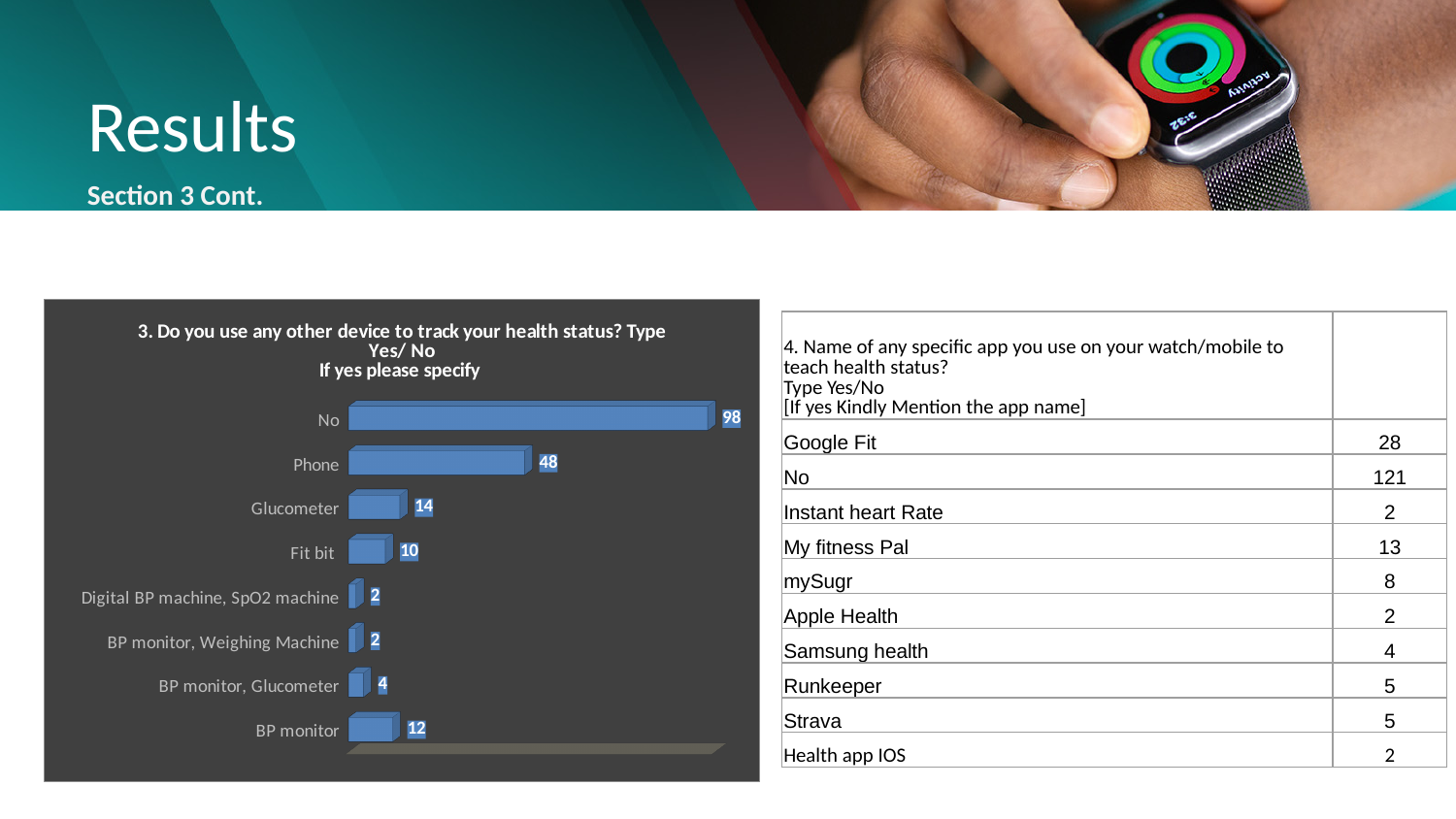
What is the value for "Fit bit" in the chart? 10 Which is larger in the chart, the value for "Glucometer" or the value for "BP monitor"? Glucometer What is the value for "No" in the chart? 98 What is the value for "Phone" in the chart? 48 What kind of chart is shown on the slide? Bar chart What is the difference between the values for "No" and "Phone" in the chart? 50 Which category has the highest value in the chart? No What is the value for "Glucometer" in the chart? 14 What is the value for "BP monitor" in the chart? 12 How many categories are shown in the chart? 8 What is the title of the chart? 3. Do you use any other device to track your health status? Type Yes/ No If yes please specify What is the value for "BP monitor, Glucometer" in the chart? 4